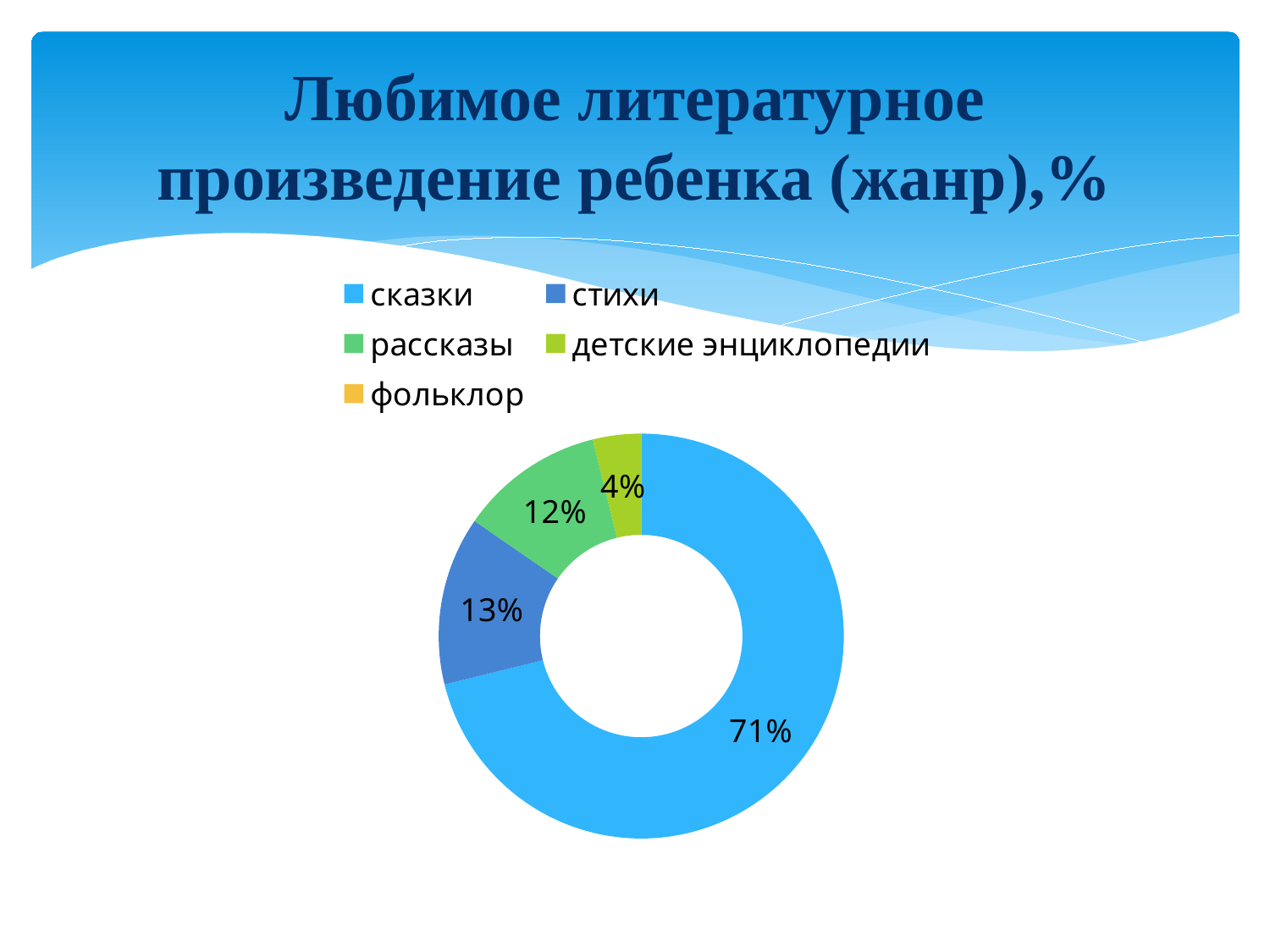
Which is larger, the share for стихи or the share for рассказы? стихи What percentage is shown for детские энциклопедии? 4% What is the difference between the shares for сказки and стихи? 58% What kind of chart is shown on the slide? doughnut chart What is the title of the slide? Любимое литературное произведение ребенка (жанр),% Which genre has the largest share of the chart? сказки What colour is the slice for сказки? light blue How many entries does the legend list? 5 What percentage is shown for сказки? 71% What percentage is shown for рассказы? 12% Which labelled slice has the smallest share of the chart? детские энциклопедии What percentage is shown for стихи? 13%